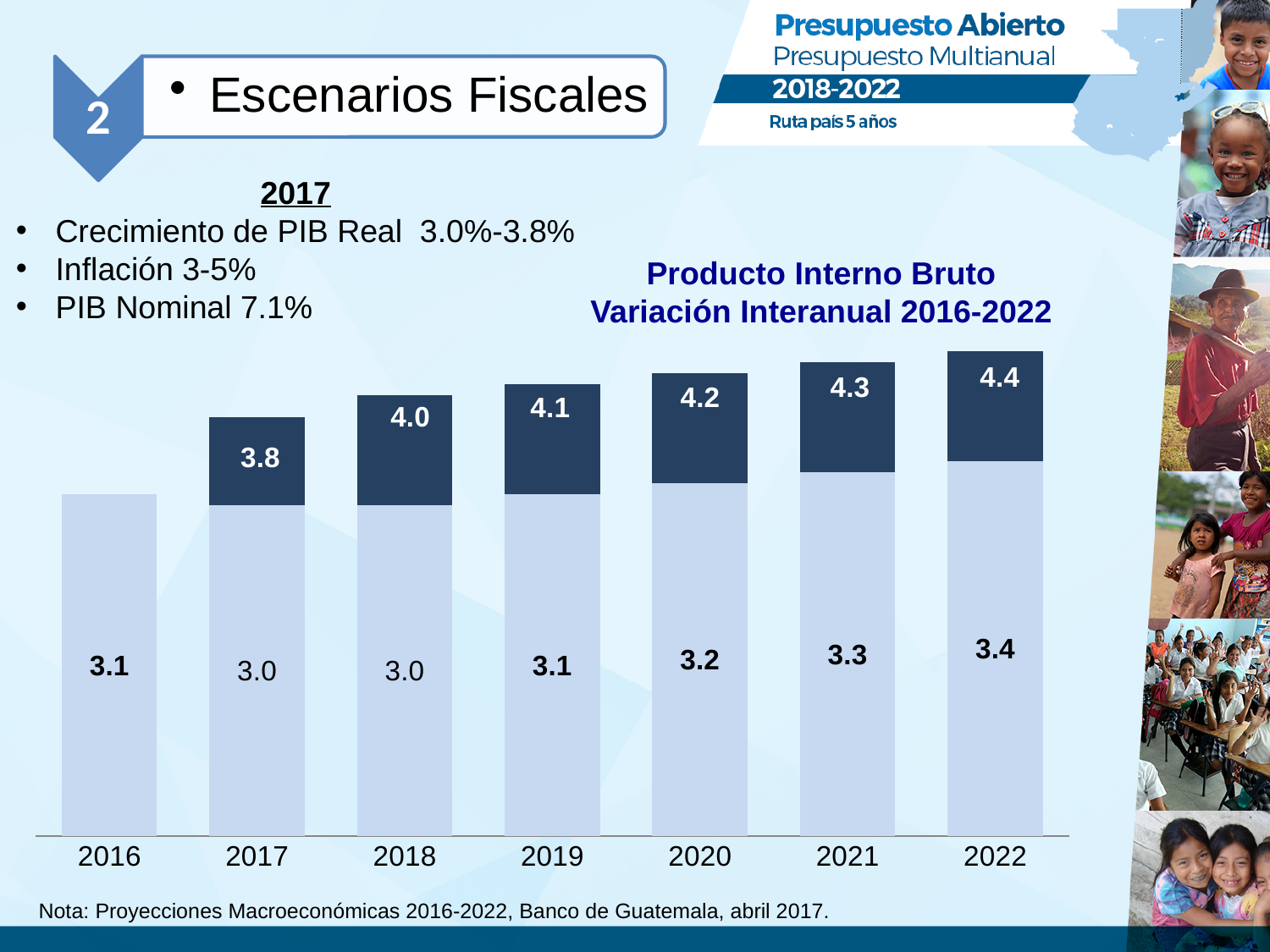
What is the title of the chart? Producto Interno Bruto Variación Interanual 2016-2022 What is the lower value shown for 2016? 3.1 What is the lower value shown for 2018? 3.0 Which year has the highest upper value in the dark segment? 2022 Do the upper values in the dark segments rise or fall from 2017 to 2022? rise What kind of chart is shown on the slide? bar chart How many years are shown on the x axis of the chart? 7 What is the upper value shown in the dark segment for 2022? 4.4 What is the difference between the upper value for 2022 and the upper value for 2017? 0.6 Which year has the highest lower value? 2022 What is the lower value shown for 2020? 3.2 What is the upper value shown in the dark segment for 2017? 3.8